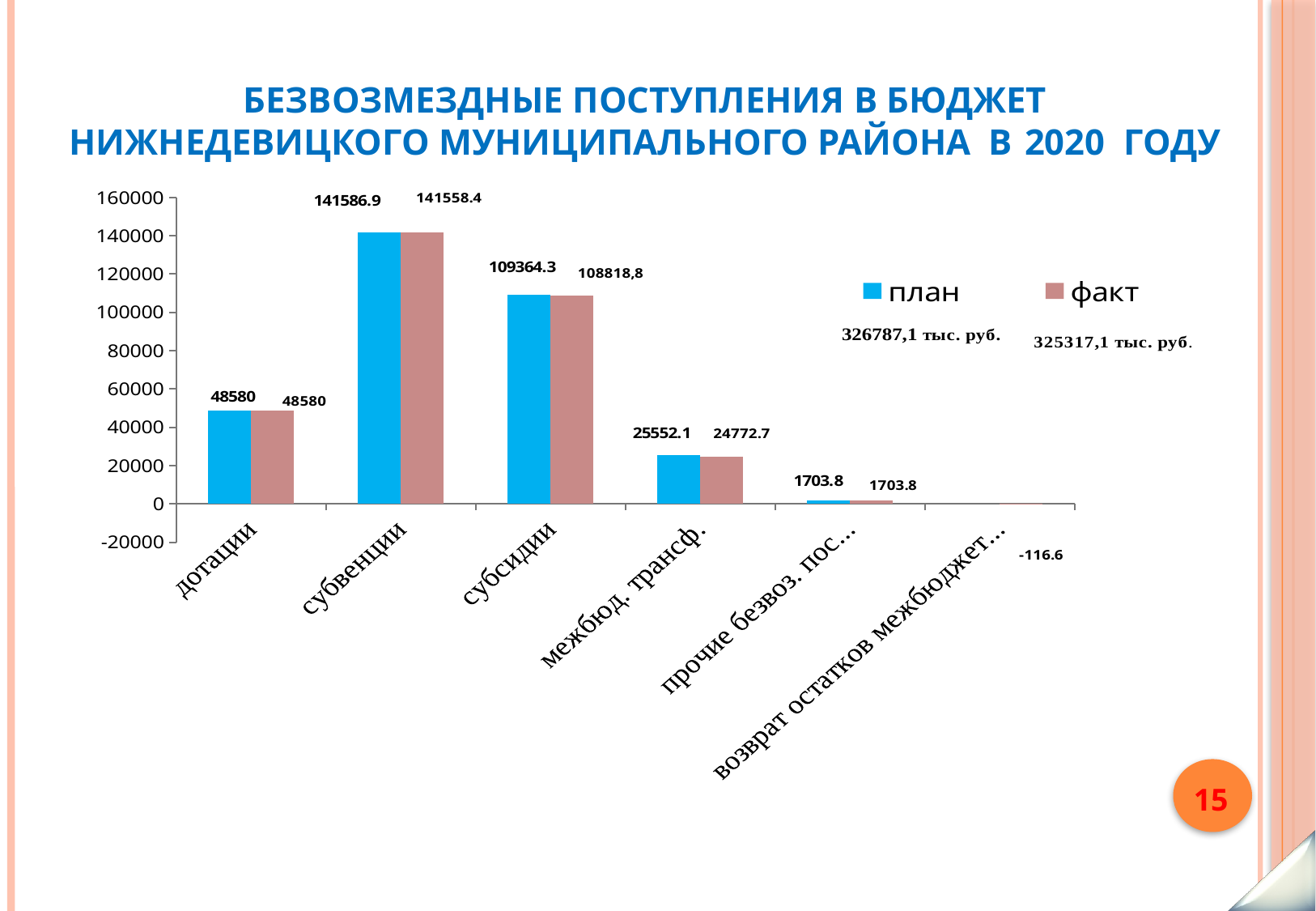
Which category has the highest план value? субвенции What kind of chart is shown on the slide? bar chart How many categories are shown on the x axis? 6 What is the факт value for межбюд. трансф.? 24772.7 What is the difference between the план and факт values for межбюд. трансф.? 779.4 What is the план value for дотации? 48580 How many series does the legend list? 2 What colour are the план bars? blue Which is larger for субсидии, the план value or the факт value? план What is the факт value for субсидии? 108818,8 What is the план value for субвенции? 141586.9 What is the difference between the план and факт values for субвенции? 28.5